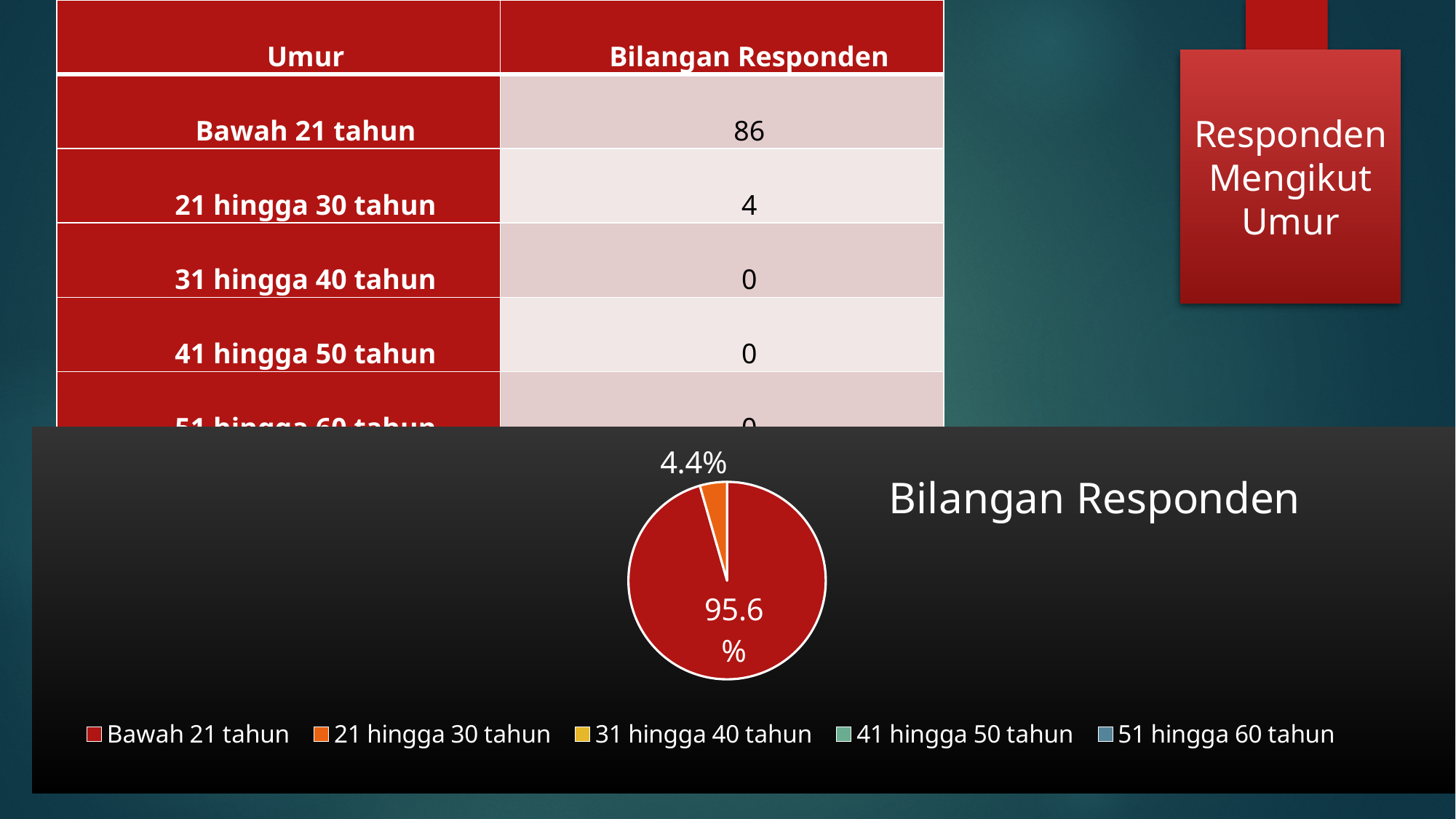
What is the title of the pie chart? Bilangan Responden Is the share for Bawah 21 tahun greater or less than 50%? greater What share of the pie does 21 hingga 30 tahun have? 4.4% How many slices in the pie chart have a percentage label? 2 What colour is the Bawah 21 tahun slice in the pie chart? red What is the difference in percentage points between the Bawah 21 tahun slice and the 21 hingga 30 tahun slice? 91.2% Which category has the largest slice of the pie? Bawah 21 tahun Which is larger in the pie chart, Bawah 21 tahun or 21 hingga 30 tahun? Bawah 21 tahun What kind of chart is shown on the slide? pie chart What share of the pie does Bawah 21 tahun have? 95.6% Is the share for 21 hingga 30 tahun greater or less than 10%? less How many categories does the pie chart's legend list? 5